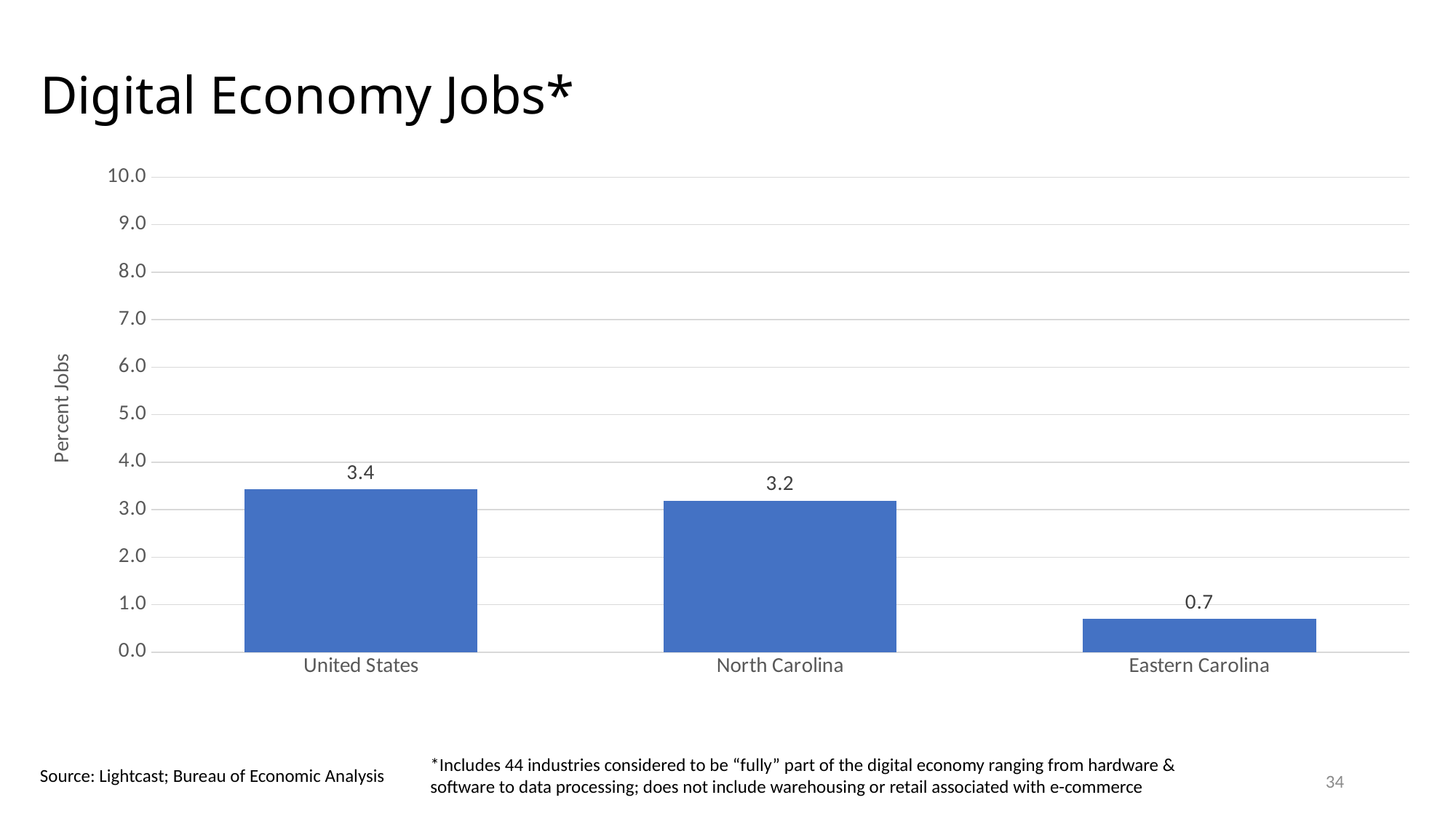
What is the value for North Carolina? 3.2 Which category has the highest value? United States Which is larger, the value for North Carolina or the value for Eastern Carolina? North Carolina What is the value for Eastern Carolina? 0.7 Is the value for Eastern Carolina greater or less than 1.0? less What is the difference between the values for North Carolina and Eastern Carolina? 2.5 How many categories are shown on the chart? 3 What is the difference between the values for United States and North Carolina? 0.2 What is the value for United States? 3.4 What kind of chart is shown on the slide? bar chart Which category has the lowest value? Eastern Carolina What is the label on the vertical axis? Percent Jobs